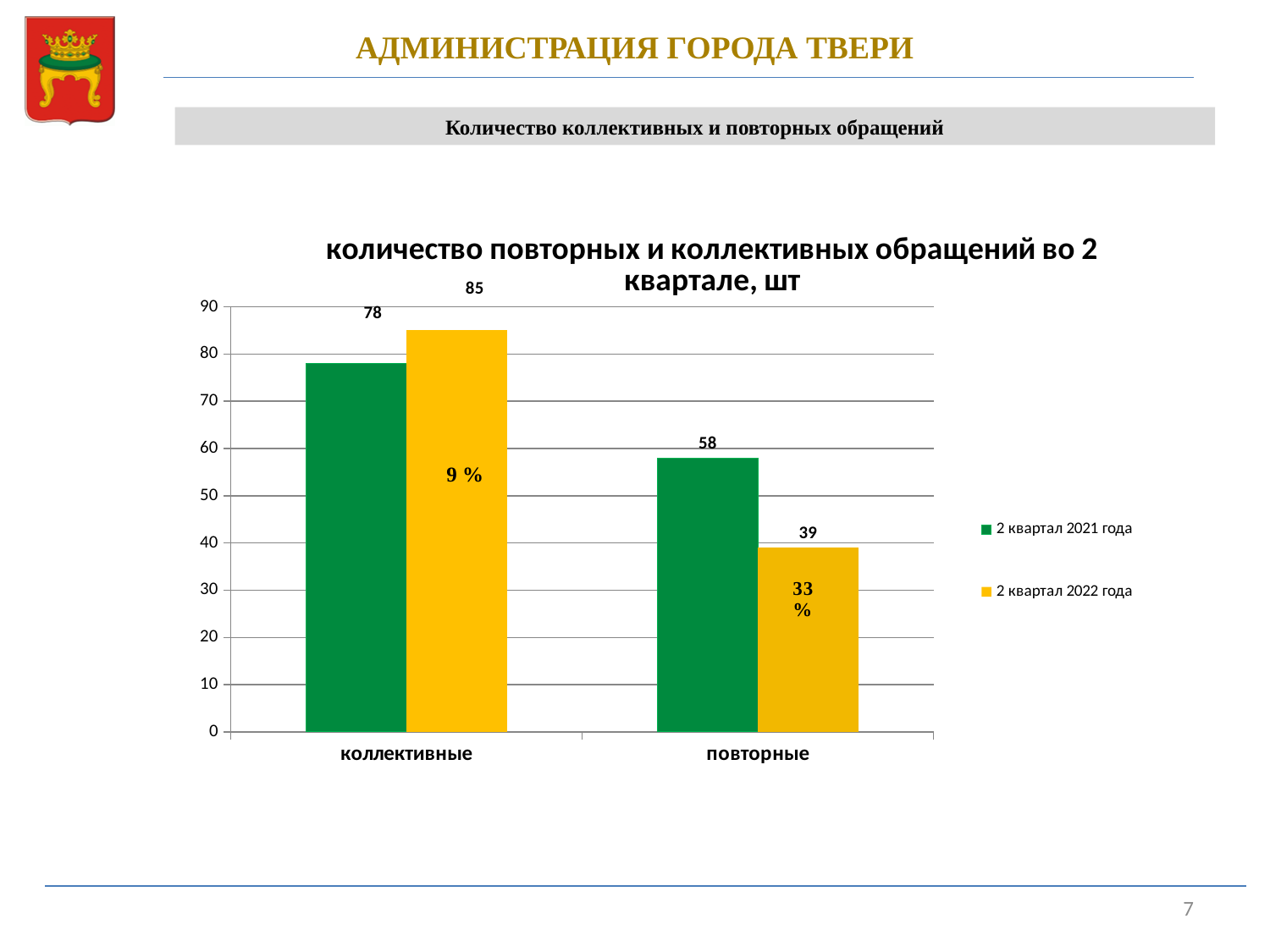
How many series does the legend list? 2 What is the value for коллективные in 2 квартал 2021 года? 78 Which is larger for повторные: 2 квартал 2021 года or 2 квартал 2022 года? 2 квартал 2021 года Which category has the highest value in 2 квартал 2022 года? коллективные What is the difference between the 2 квартал 2022 года and 2 квартал 2021 года values for коллективные? 7 What is the difference between the 2 квартал 2021 года and 2 квартал 2022 года values for повторные? 19 What is the value for коллективные in 2 квартал 2022 года? 85 How many categories are shown on the x axis? 2 Which category has the lowest value in 2 квартал 2021 года? повторные What is the value for повторные in 2 квартал 2021 года? 58 What kind of chart is shown on the slide? bar chart What is the value for повторные in 2 квартал 2022 года? 39